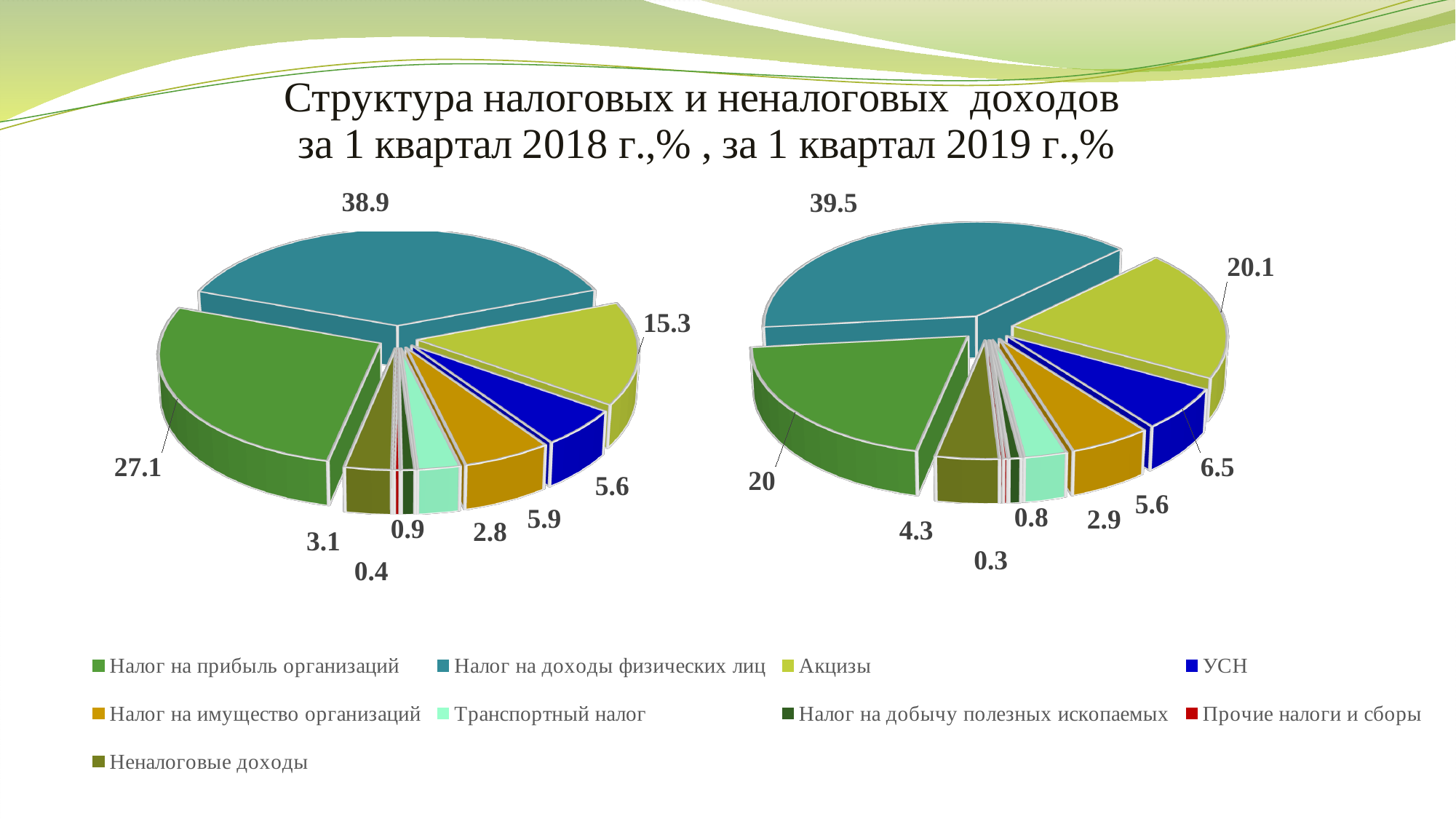
In the left pie chart (1 квартал 2018), what is the value for Налог на прибыль организаций? 27.1 In the left pie chart (1 квартал 2018), which category has the largest share? Налог на доходы физических лиц In the right pie chart (1 квартал 2019), what is the value for УСН? 6.5 What is the title of the slide's chart? Структура налоговых и неналоговых доходов за 1 квартал 2018 г.,% , за 1 квартал 2019 г.,% In the left pie chart (1 квартал 2018), what is the value for Налог на доходы физических лиц? 38.9 What type of charts are shown on the slide? Pie charts How many categories does the legend list? 9 In the right pie chart (1 квартал 2019), what is the value for Налог на доходы физических лиц? 39.5 In the right pie chart (1 квартал 2019), which category has the smallest share? Прочие налоги и сборы In the right pie chart (1 квартал 2019), what is the difference between the values for Налог на доходы физических лиц and Акцизы? 19.4 In the right pie chart (1 квартал 2019), what is the value for Акцизы? 20.1 In the left pie chart (1 квартал 2018), which is larger: Акцизы or УСН? Акцизы